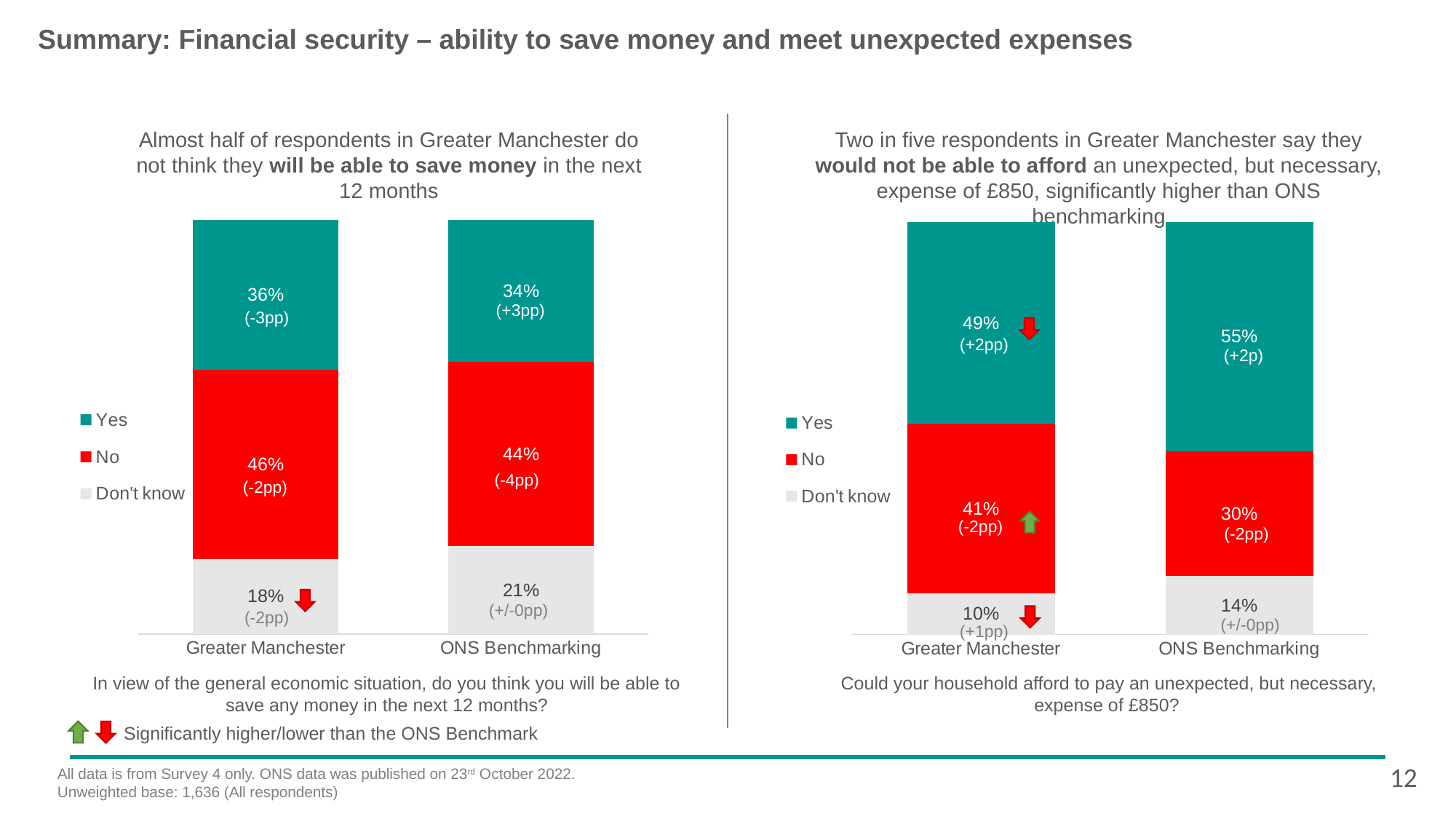
In the right chart, what is the total of the Greater Manchester stacked bar? 100% In the right chart (afford an unexpected £850 expense), what is the 'No' value for Greater Manchester? 41% In the right chart (afford an unexpected £850 expense), what is the 'Yes' value for ONS Benchmarking? 55% In the left chart, which is larger: the 'Yes' value for Greater Manchester or for ONS Benchmarking? Greater Manchester What type of chart is used on the left side of the slide? Stacked bar chart In the left chart, which segment is the largest for ONS Benchmarking? No How many categories are shown on the x axis of the right chart? 2 In the right chart, what is the difference between the 'No' values for Greater Manchester and ONS Benchmarking? 11 percentage points In the left chart (ability to save money), what is the 'Don't know' value for ONS Benchmarking? 21% In the left chart (ability to save money), what is the 'No' value for Greater Manchester? 46% In the right chart, which segment is the smallest for Greater Manchester? Don't know How many series does the legend of the left chart list? 3